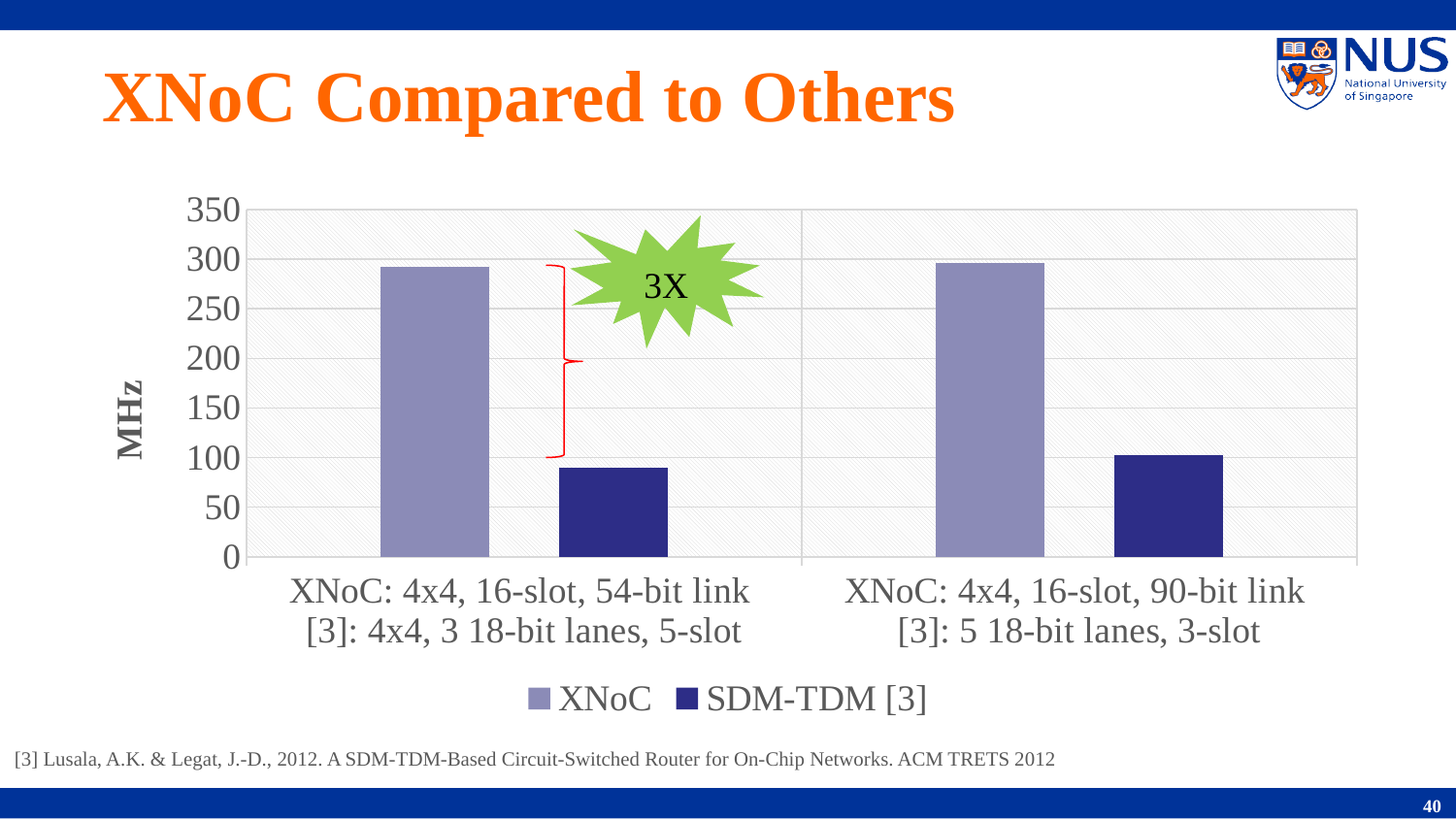
How many series does the legend list? 2 Which series has the lowest bar in the chart? SDM-TDM [3] In the group 'XNoC: 4x4, 16-slot, 90-bit link / [3]: 5 18-bit lanes, 3-slot', which series has the larger value, XNoC or SDM-TDM [3]? XNoC What kind of chart is shown on the slide? bar chart How many category groups are shown on the x axis? 2 What is the label on the vertical axis? MHz In the group 'XNoC: 4x4, 16-slot, 54-bit link / [3]: 4x4, 3 18-bit lanes, 5-slot', is the XNoC value greater or less than 250? greater In the group 'XNoC: 4x4, 16-slot, 54-bit link / [3]: 4x4, 3 18-bit lanes, 5-slot', which series has the larger value, XNoC or SDM-TDM [3]? XNoC In the group 'XNoC: 4x4, 16-slot, 90-bit link / [3]: 5 18-bit lanes, 3-slot', is the SDM-TDM [3] value greater or less than 150? less In the group 'XNoC: 4x4, 16-slot, 90-bit link / [3]: 5 18-bit lanes, 3-slot', is the XNoC value greater or less than 250? greater What are the two series named in the legend? XNoC and SDM-TDM [3]